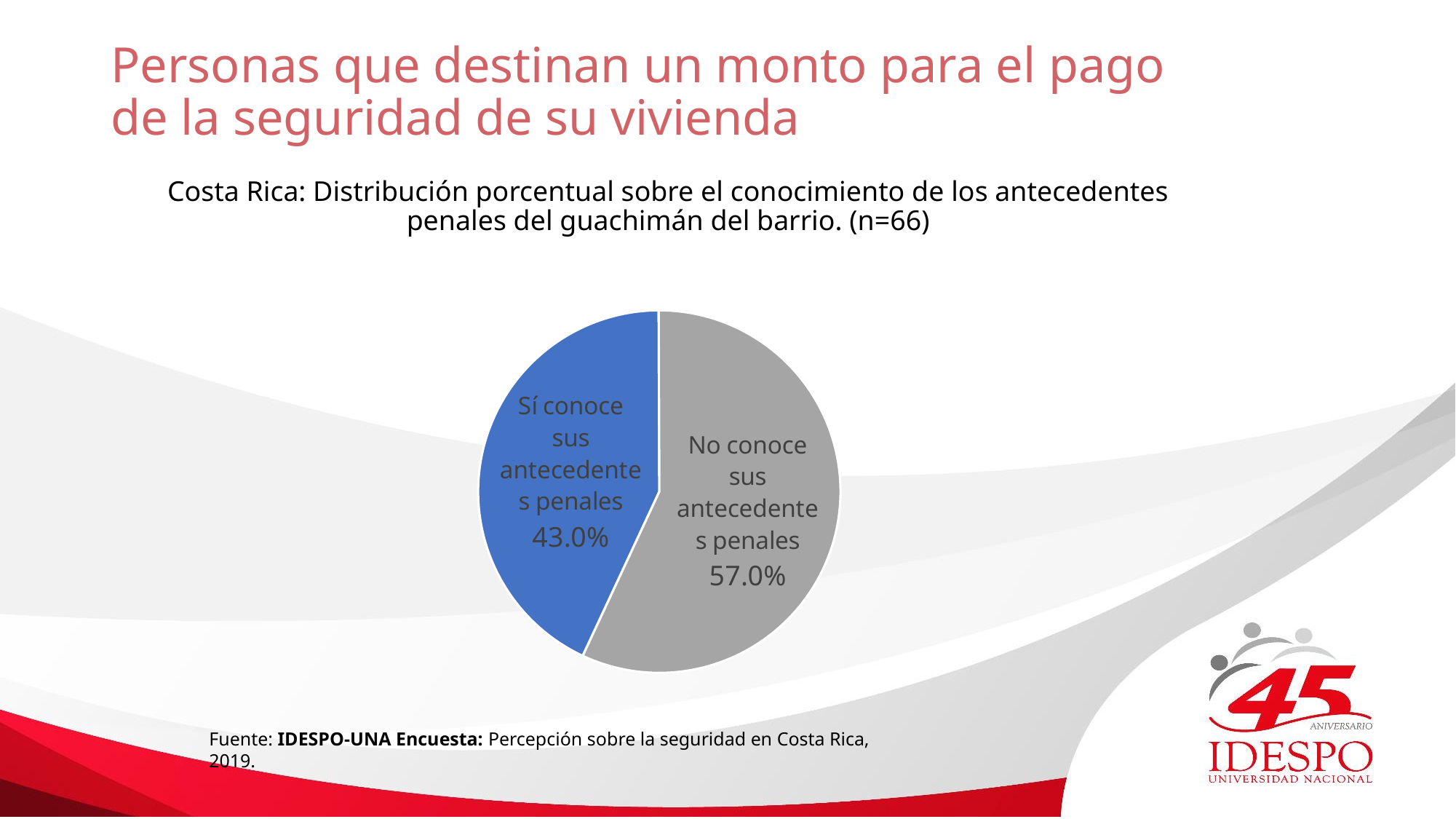
What kind of chart is shown on the slide? pie chart Is the share of respondents who know the watchman's criminal record greater or less than 50%? less What percentage of respondents know the criminal record of the neighbourhood watchman (Sí conoce sus antecedentes penales)? 43.0% Which slice of the pie is the smallest? Sí conoce sus antecedentes penales What is the sample size (n) stated in the chart subtitle? 66 What percentage of respondents do not know the criminal record of the neighbourhood watchman (No conoce sus antecedentes penales)? 57.0% Which slice of the pie is the largest? No conoce sus antecedentes penales Which is larger: the share that knows the watchman's criminal record or the share that does not? No conoce sus antecedentes penales How many slices does the pie chart have? 2 What colour is the 'Sí conoce sus antecedentes penales' slice? blue What is the difference in percentage points between the 'No conoce' and 'Sí conoce' slices? 14.0 percentage points